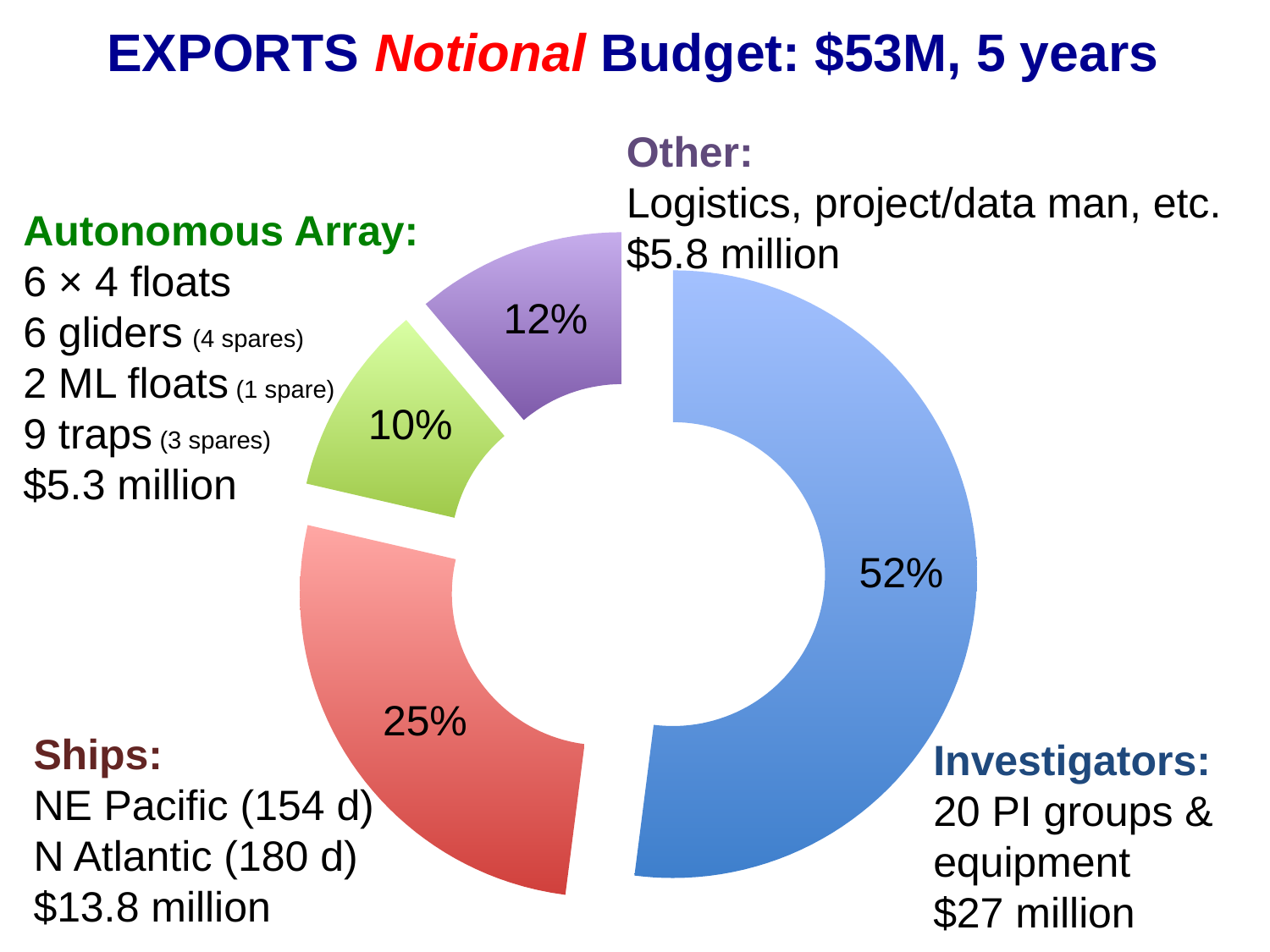
Which category has the largest share of the budget? Investigators Which has a larger share of the budget, Other or Autonomous Array? Other What is the dollar amount shown for the Ships category? $13.8 million What kind of chart is shown on the slide? Doughnut chart How many percentage points larger is the Investigators share than the Ships share? 27 What share of the budget goes to Investigators? 52% How many segments does the chart have? 4 What share of the budget does the Autonomous Array receive? 10% What percentage of the budget is allocated to Ships? 25% Which category has the smallest share of the budget? Autonomous Array What is the total budget stated in the slide title? $53M What percentage of the budget is labelled Other? 12%